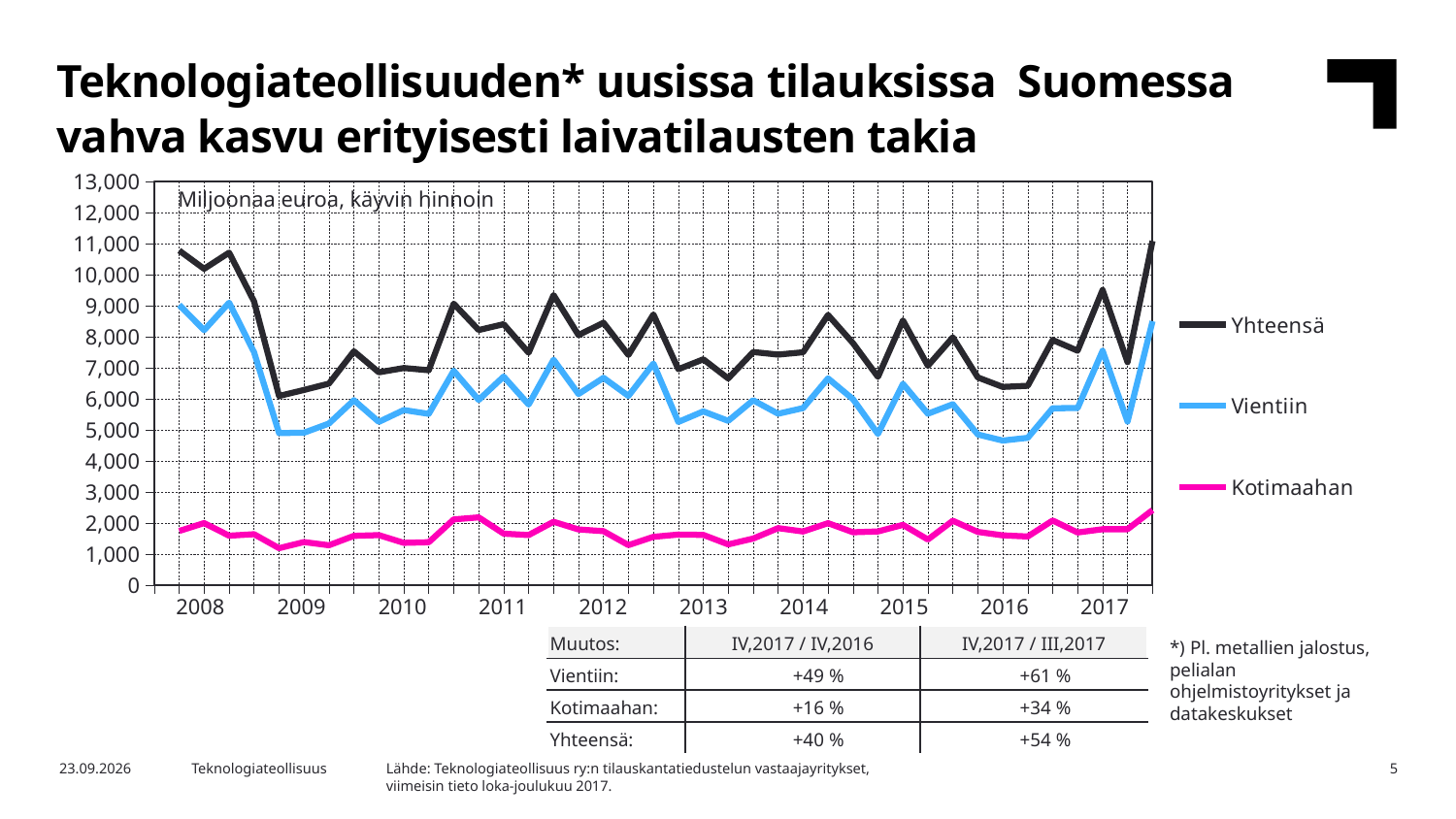
Is the value for Kotimaahan at the start of 2008 greater or less than 3,000? less How many series does the chart legend list? 3 Which series has the highest values throughout the chart? Yhteensä What kind of chart is shown on the slide? line chart What unit label is printed inside the chart area? Miljoonaa euroa, käyvin hinnoin Which series has the lowest values throughout the chart? Kotimaahan What are the three series named in the chart legend? Yhteensä, Vientiin, Kotimaahan Does the Yhteensä line rise or fall between the start of 2008 and the start of 2009? fall Which is larger at the end of 2017, the value for Vientiin or the value for Kotimaahan? Vientiin Is the value for Vientiin at the start of 2009 greater or less than 6,000? less Is the value for Yhteensä at the start of 2008 greater or less than 10,000? greater How many years are labelled on the x axis of the chart? 10